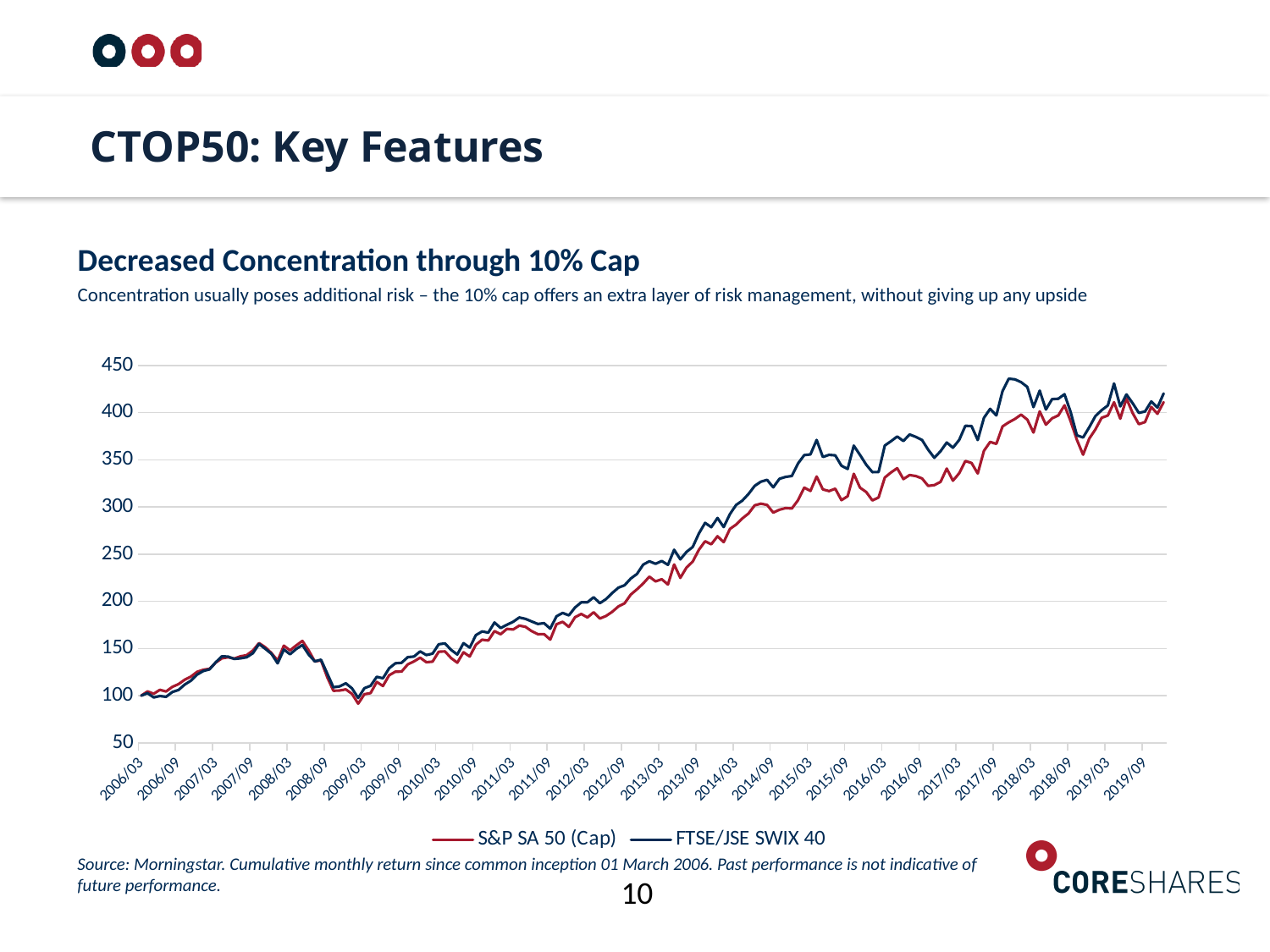
Is the value for FTSE/JSE SWIX 40 at 2016/03 greater or less than 300? greater How many series does the chart legend list? 2 What is the highest value shown on the chart's vertical axis? 450 Is the value for S&P SA 50 (Cap) at 2013/03 greater or less than 200? greater At 2015/03, which series has the higher value, S&P SA 50 (Cap) or FTSE/JSE SWIX 40? FTSE/JSE SWIX 40 Which series is drawn in dark blue in the chart? FTSE/JSE SWIX 40 Which series is drawn in red in the chart? S&P SA 50 (Cap) Overall, do the values of the S&P SA 50 (Cap) series rise or fall from 2006/03 to 2019/09? rise What is the starting value of both series at 2006/03? 100 What type of chart is shown on the slide? line chart